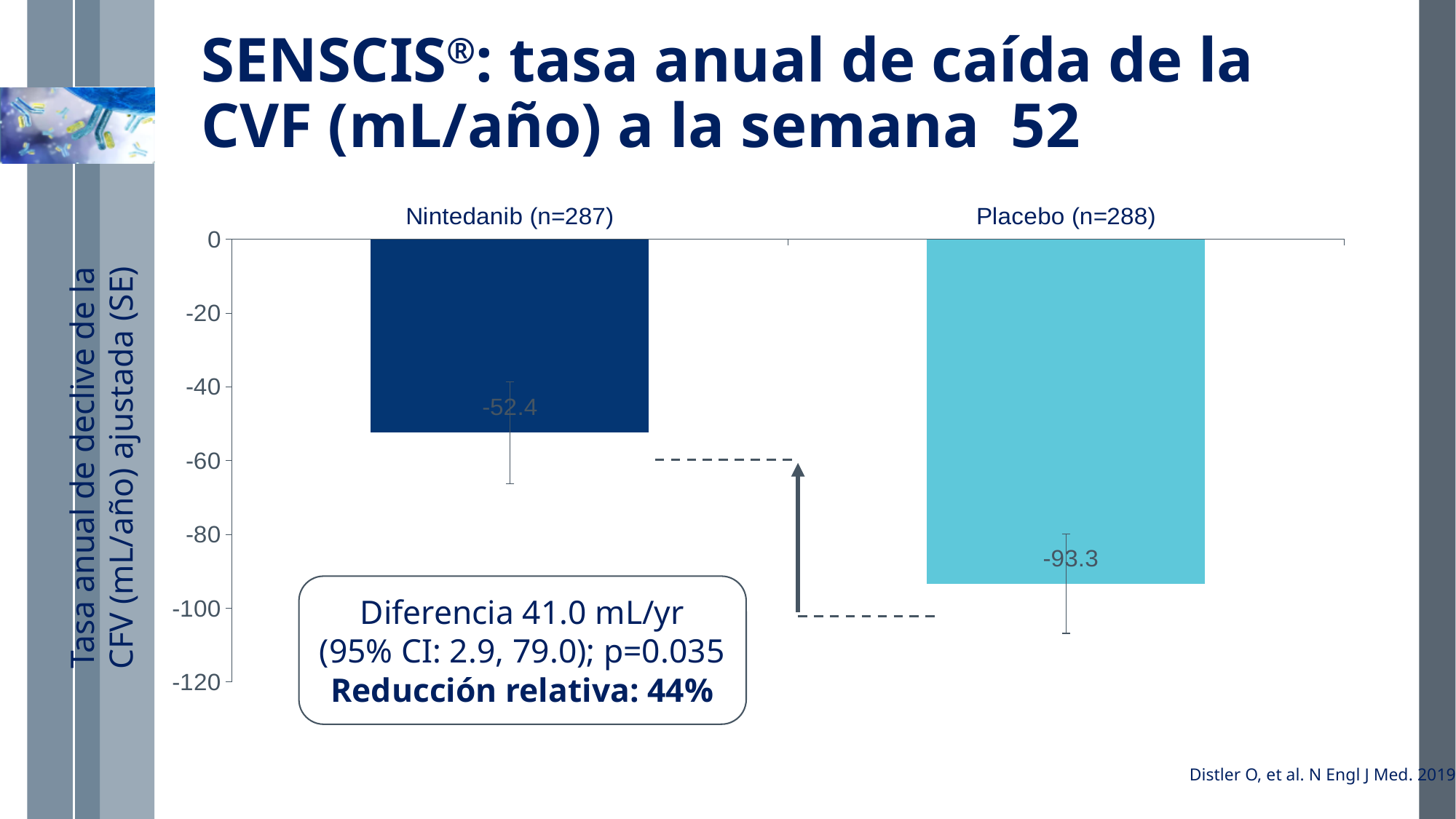
What is the lowest tick value shown on the y axis? -120 Which category has the highest (least negative) value? Nintedanib (n=287) Which bar shows a larger decline, Nintedanib or Placebo? Placebo How many categories are plotted in the chart? 2 What is the difference between the Nintedanib and Placebo values? 40.9 What is the value for Placebo (n=288)? -93.3 What kind of chart is shown on the slide? Bar chart Which category has the lowest (most negative) value? Placebo (n=288) What relative reduction is stated in the text box on the chart? 44% Is the value for Placebo (n=288) greater or less than -80? less What is the value for Nintedanib (n=287)? -52.4 Is the value for Nintedanib (n=287) greater or less than -60? greater